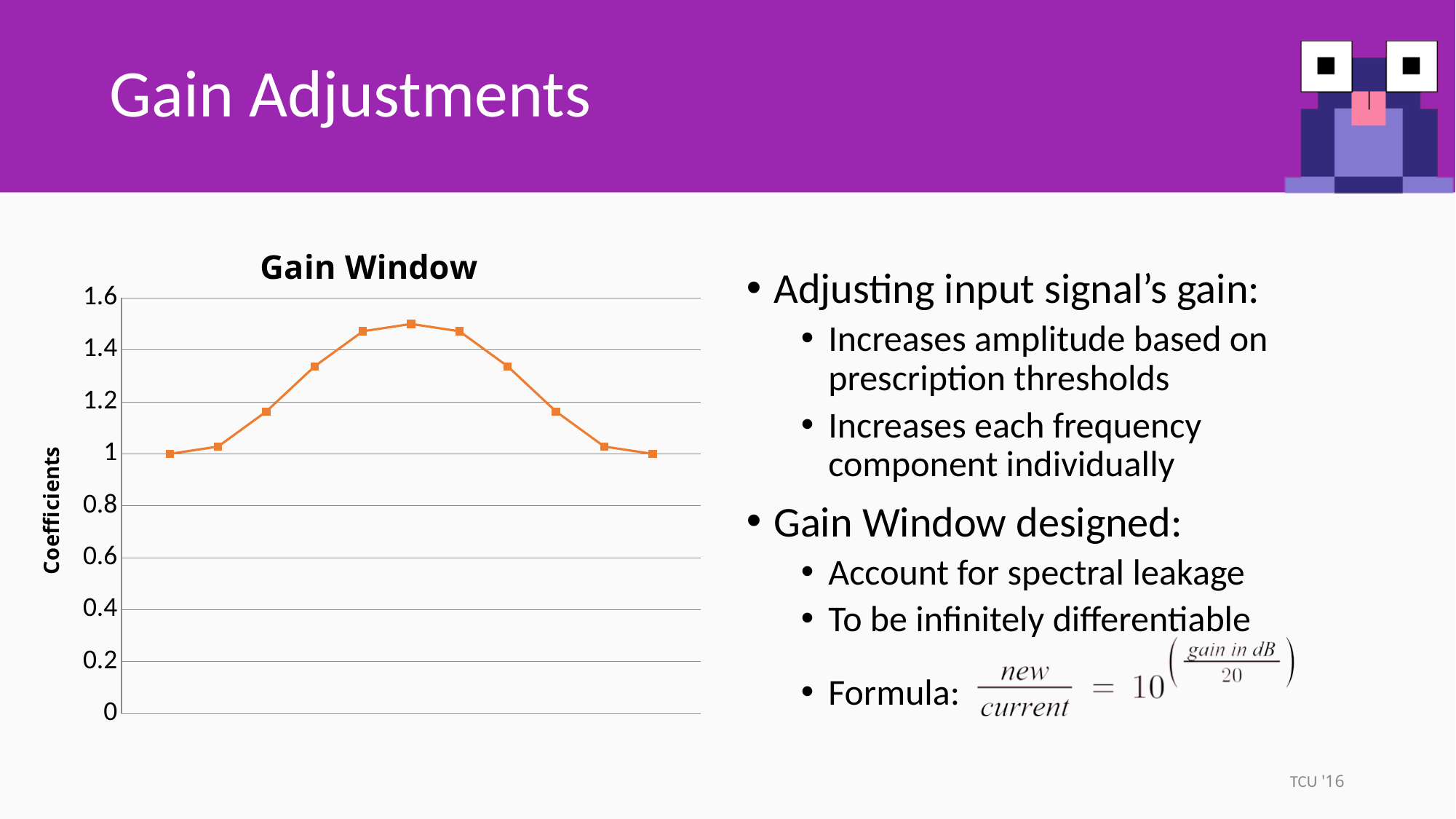
How many data points are plotted on the line in the Gain Window chart? 11 What is the label on the vertical axis of the chart? Coefficients What kind of chart is shown on the slide? line chart What is the value of the last (rightmost) data point in the Gain Window chart? 1 Is the value of the 4th data point from the left greater or less than 1.2? greater What is the title of the chart? Gain Window How do the values change from left to right along the x axis in the Gain Window chart? they rise to a peak in the middle and then fall Is the value of the 3rd data point from the left greater or less than 1.2? less Is the value of the highest point in the Gain Window chart greater or less than 1.4? greater What is the value of the first (leftmost) data point in the Gain Window chart? 1 Which data point has the highest value in the Gain Window chart? the middle (6th) point